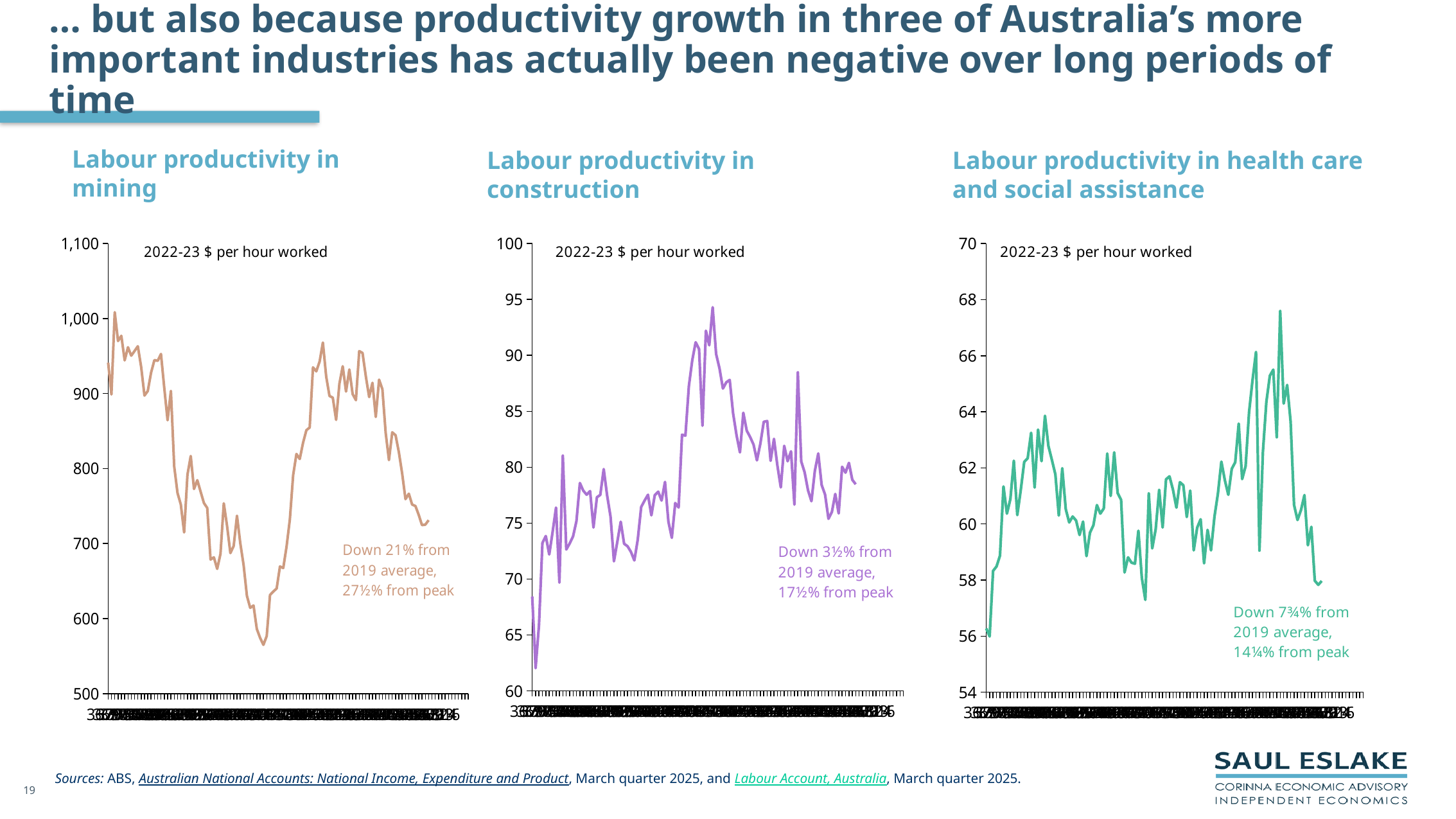
In the 'Labour productivity in construction' chart, is the highest point of the line greater or less than 90? greater In the 'Labour productivity in construction' chart, is the final value of the line greater or less than 80? less In the 'Labour productivity in mining' chart, by what percentage is productivity down from its peak, according to the annotation? 27½% In the 'Labour productivity in construction' chart, by what percentage is productivity down from the 2019 average, according to the annotation? 3½% What type of chart is used for 'Labour productivity in mining'? Line chart What unit is shown on the y-axis of the 'Labour productivity in construction' chart? 2022-23 $ per hour worked In the 'Labour productivity in health care and social assistance' chart, is the highest point of the line greater or less than 66? greater How many charts are shown on the slide? 3 In the 'Labour productivity in health care and social assistance' chart, by what percentage is productivity down from its peak, according to the annotation? 14¼%